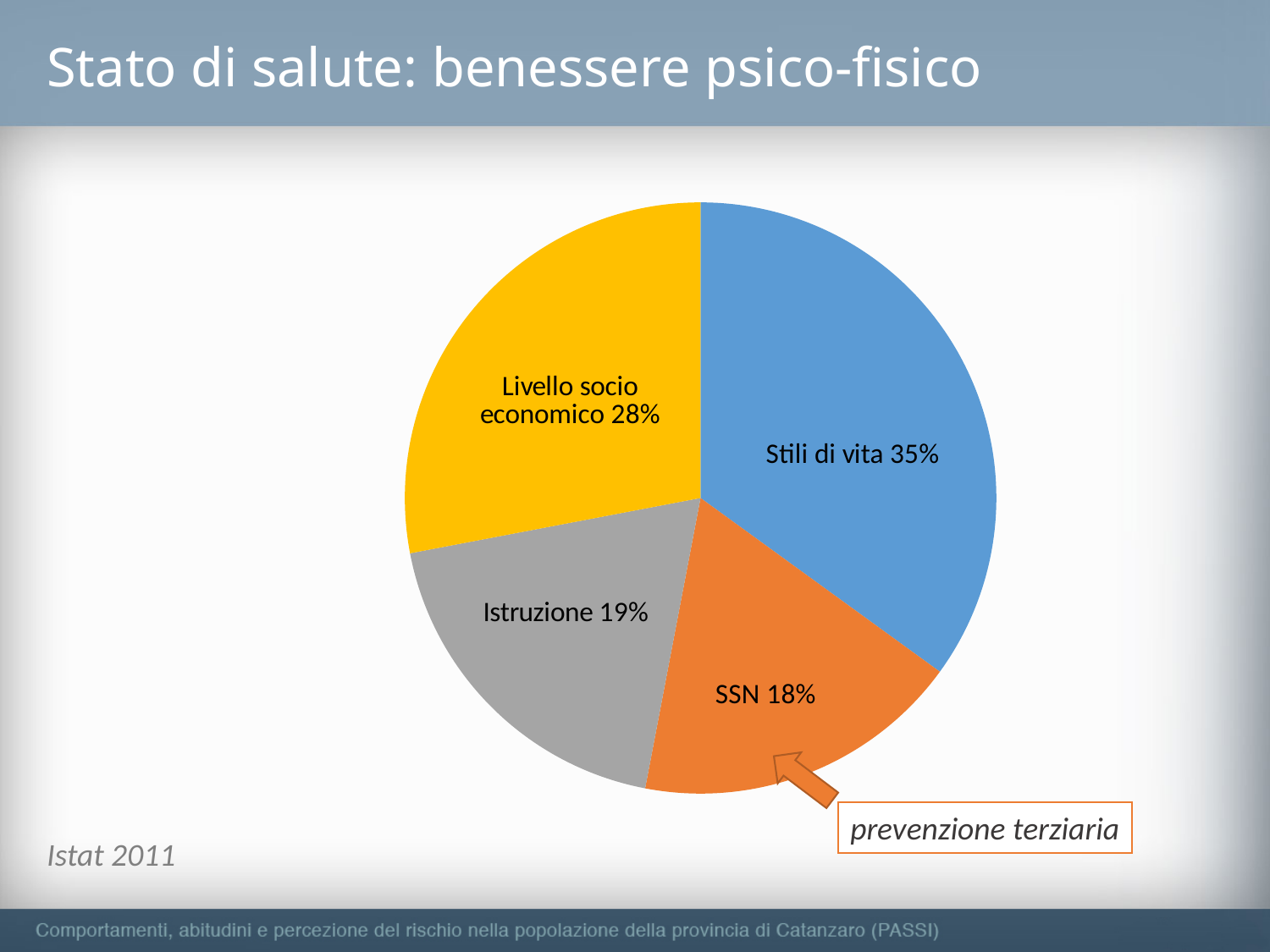
What percentage does the pie chart show for Stili di vita? 35% Which slice of the pie chart is the largest? Stili di vita Which slice of the pie chart is the smallest? SSN What kind of chart is shown on the slide? Pie chart What is the difference in percentage points between Stili di vita and Livello socio economico? 7 What percentage does the pie chart show for SSN? 18% What colour is the SSN slice of the pie chart? Orange How many slices does the pie chart have? 4 What percentage does the pie chart show for Livello socio economico? 28% What is the difference in percentage points between Istruzione and SSN? 1 Which is larger, Livello socio economico or Istruzione? Livello socio economico What percentage does the pie chart show for Istruzione? 19%